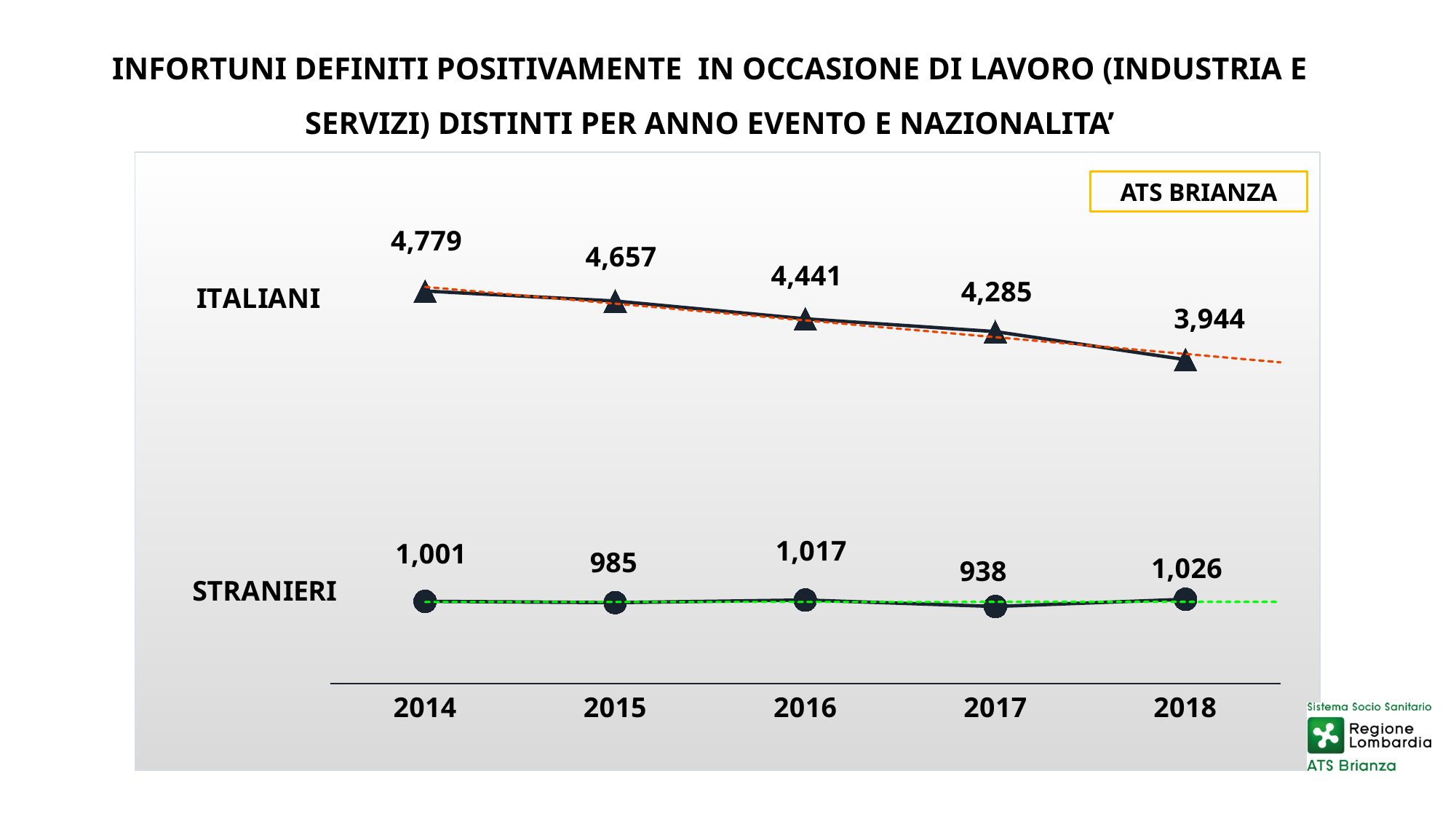
In which year is the STRANIERI value highest? 2018 What is the value for STRANIERI in 2017? 938 How many years are shown on the x axis? 5 In which year is the ITALIANI value lowest? 2018 What kind of chart is this? Line chart What is the value for STRANIERI in 2016? 1,017 Which is larger, the STRANIERI value in 2015 or in 2016? 2016 What is the difference between the ITALIANI values in 2014 and 2018? 835 What is the value for ITALIANI in 2018? 3,944 Do the ITALIANI values rise or fall from 2014 to 2018? Fall What is the value for ITALIANI in 2014? 4,779 In which year is the STRANIERI value lowest? 2017